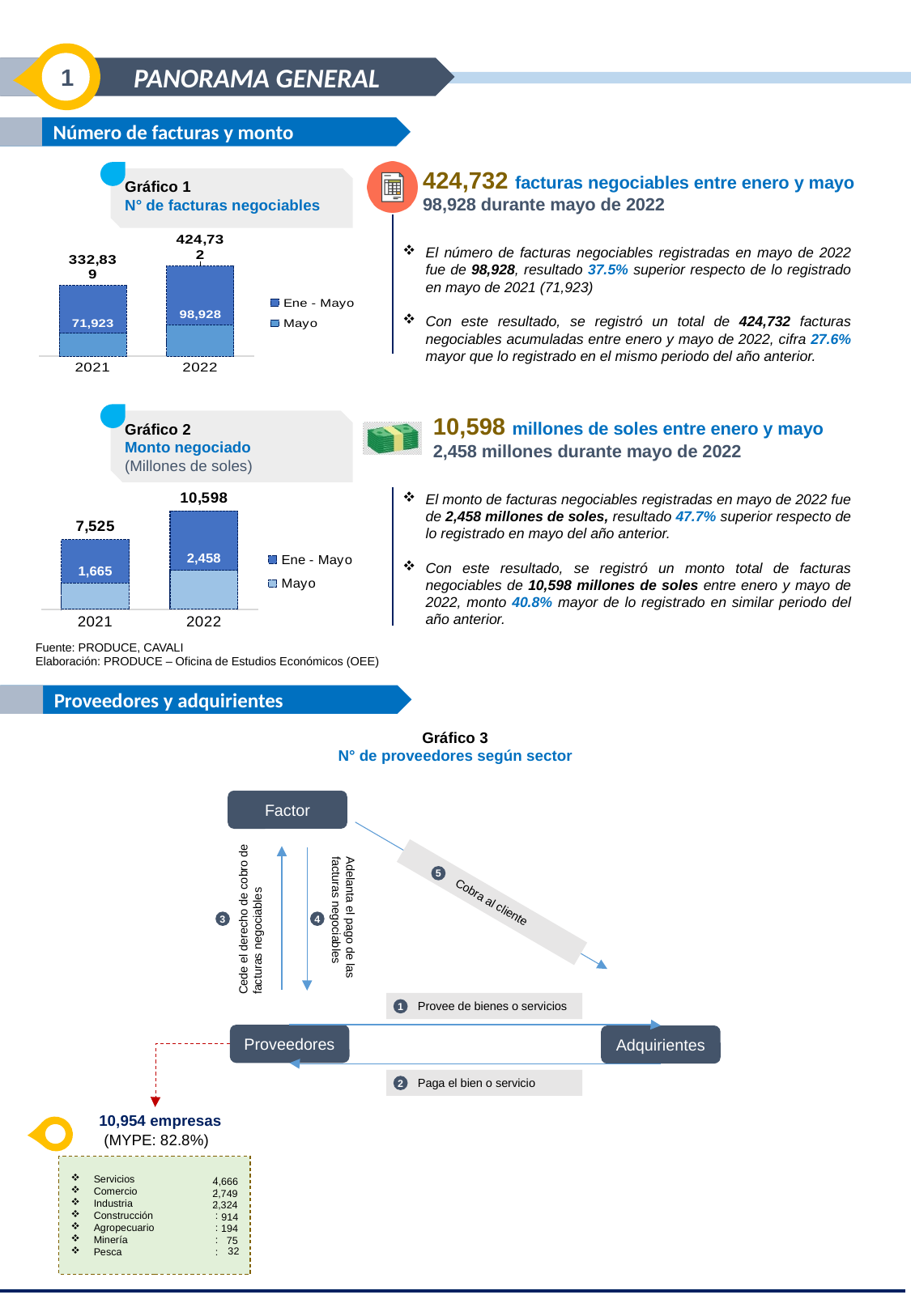
In Gráfico 2 (Monto negociado), what unit is given in the chart title? Millones de soles In Gráfico 1 (N° de facturas negociables), what is the total value shown above the bar for 2022? 424,732 In Gráfico 2 (Monto negociado), what is the total value shown above the bar for 2022? 10,598 In Gráfico 1 (N° de facturas negociables), what kind of chart is shown? Bar chart In Gráfico 1 (N° de facturas negociables), what is the total value shown above the bar for 2021? 332,839 In Gráfico 1 (N° de facturas negociables), what is the difference between the Mayo values for 2022 and 2021? 27,005 In Gráfico 2 (Monto negociado), what value is labelled for Mayo in 2021? 1,665 In Gráfico 2 (Monto negociado), how many years are shown on the x axis? 2 In Gráfico 2 (Monto negociado), what is the difference between the totals for 2022 and 2021? 3,073 In Gráfico 1 (N° de facturas negociables), what value is labelled for Mayo in 2022? 98,928 In Gráfico 2 (Monto negociado), which year has the higher total? 2022 In Gráfico 1 (N° de facturas negociables), how many series does the legend list? 2